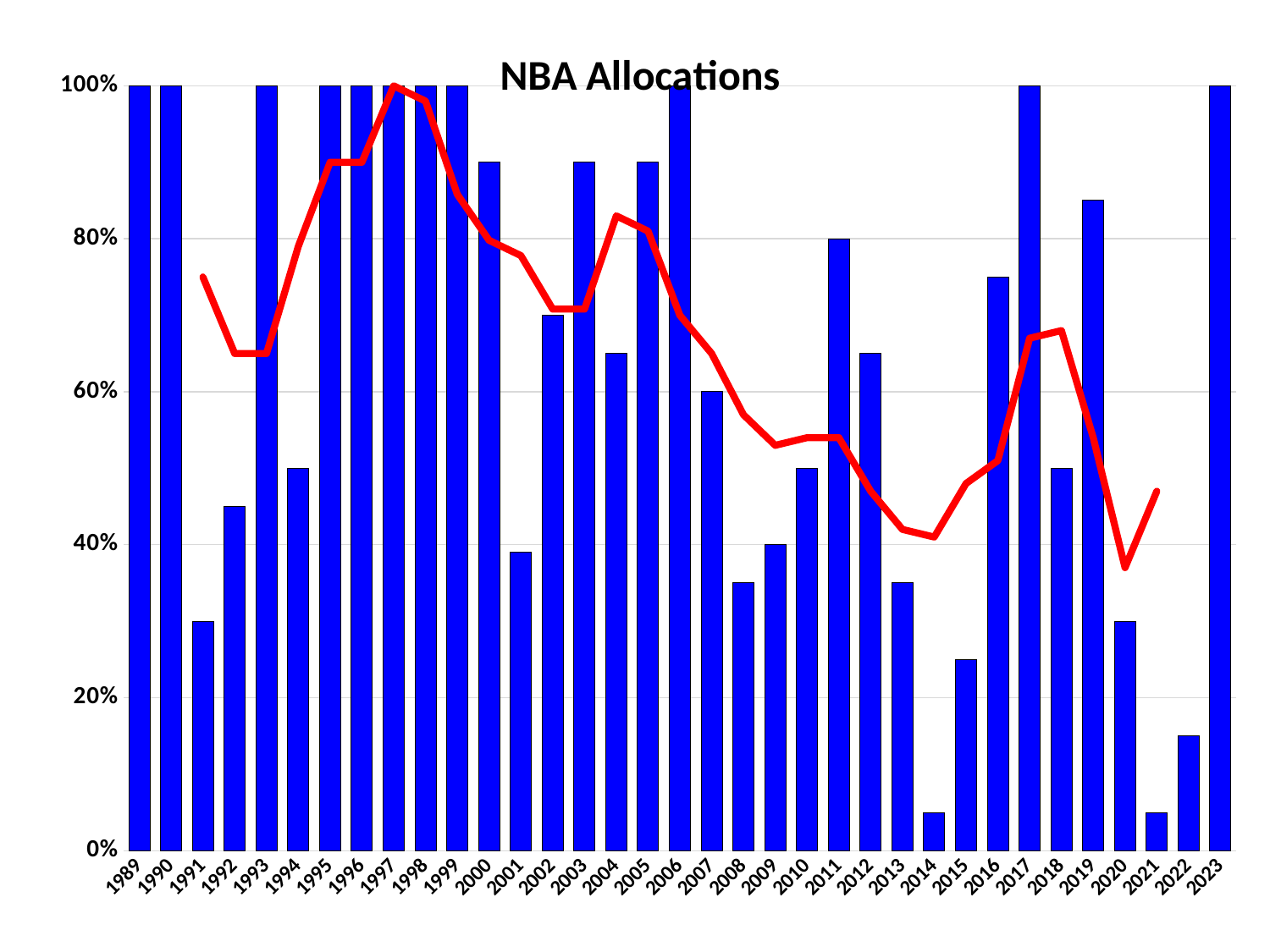
What is the title of the chart? NBA Allocations What is the value for 2023 in the NBA Allocations chart? 100% Is the value for 1991 greater or less than 40%? less Do the bar values rise or fall from 2017 to 2021? fall Is the value for 2022 greater or less than 20%? less What is the value for 2007 in the NBA Allocations chart? 60% What kind of chart is shown on the slide? Bar chart with a line overlay What is the value for 2011 in the NBA Allocations chart? 80% Which year has the larger bar, 2019 or 2020? 2019 What is the value for 2009 in the NBA Allocations chart? 40% How many years are shown on the x axis of the NBA Allocations chart? 35 Is the value for 2019 greater or less than 80%? greater